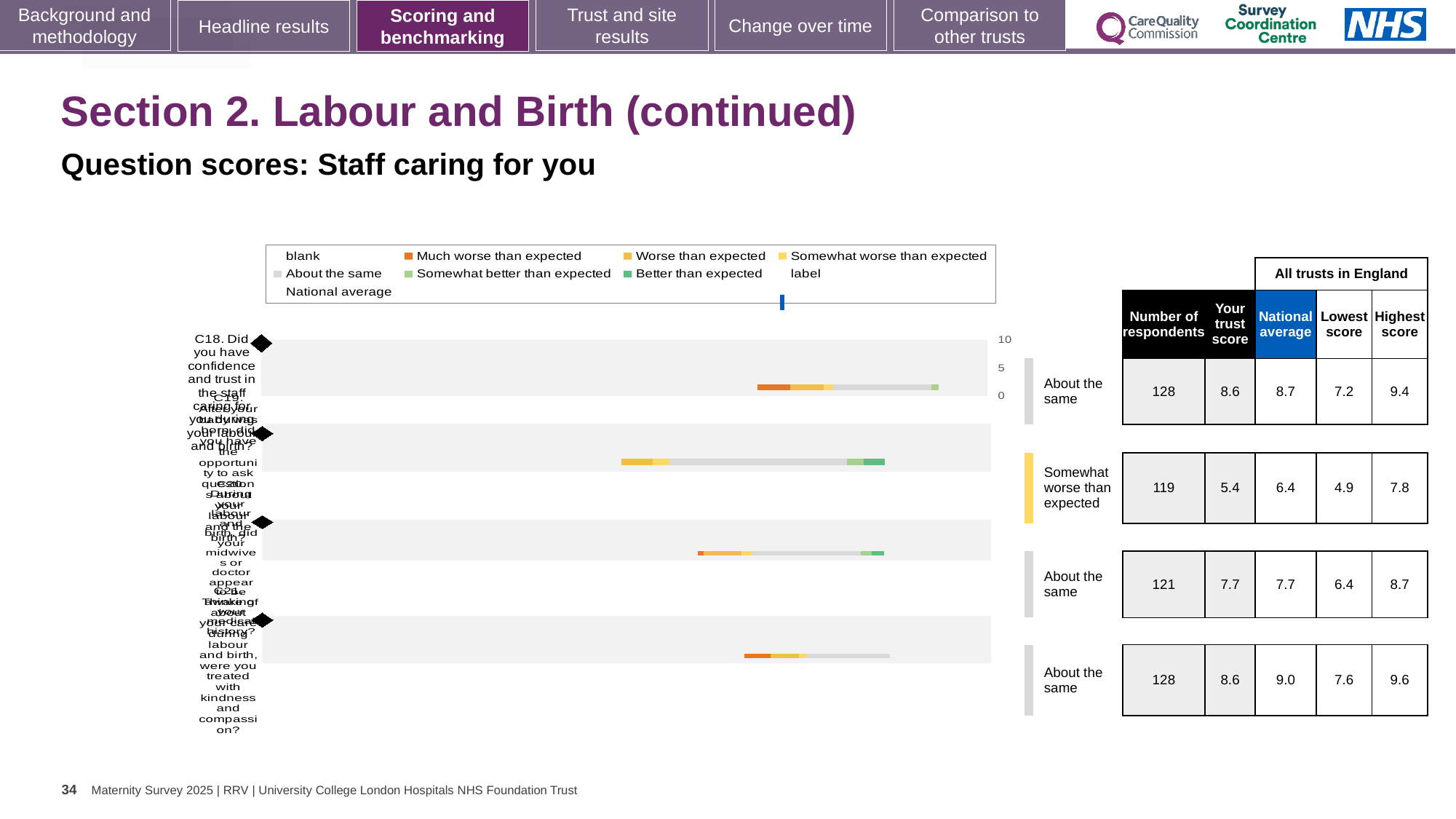
What kind of chart is shown on the slide? bar chart Which row has the lowest 'Your trust score' in the table? the second row (5.4) What is the highest score among all trusts in England for the second row? 7.8 For the fourth (bottom) row, which is larger: the trust score or the national average? the national average (9.0) What is the number of respondents for the first row (C18) in the table? 128 For the second row, what is the difference between the national average and the trust score? 1.0 What is the lowest score among all trusts in England for the third row? 6.4 How many question rows are plotted in the chart? 4 For the first row (C18), what is the difference between the highest score and the lowest score? 2.2 What is the national average for the fourth (bottom) row of the table? 9.0 What benchmark category is shown for the second row? Somewhat worse than expected What is the 'Your trust score' value for the second row of the table? 5.4